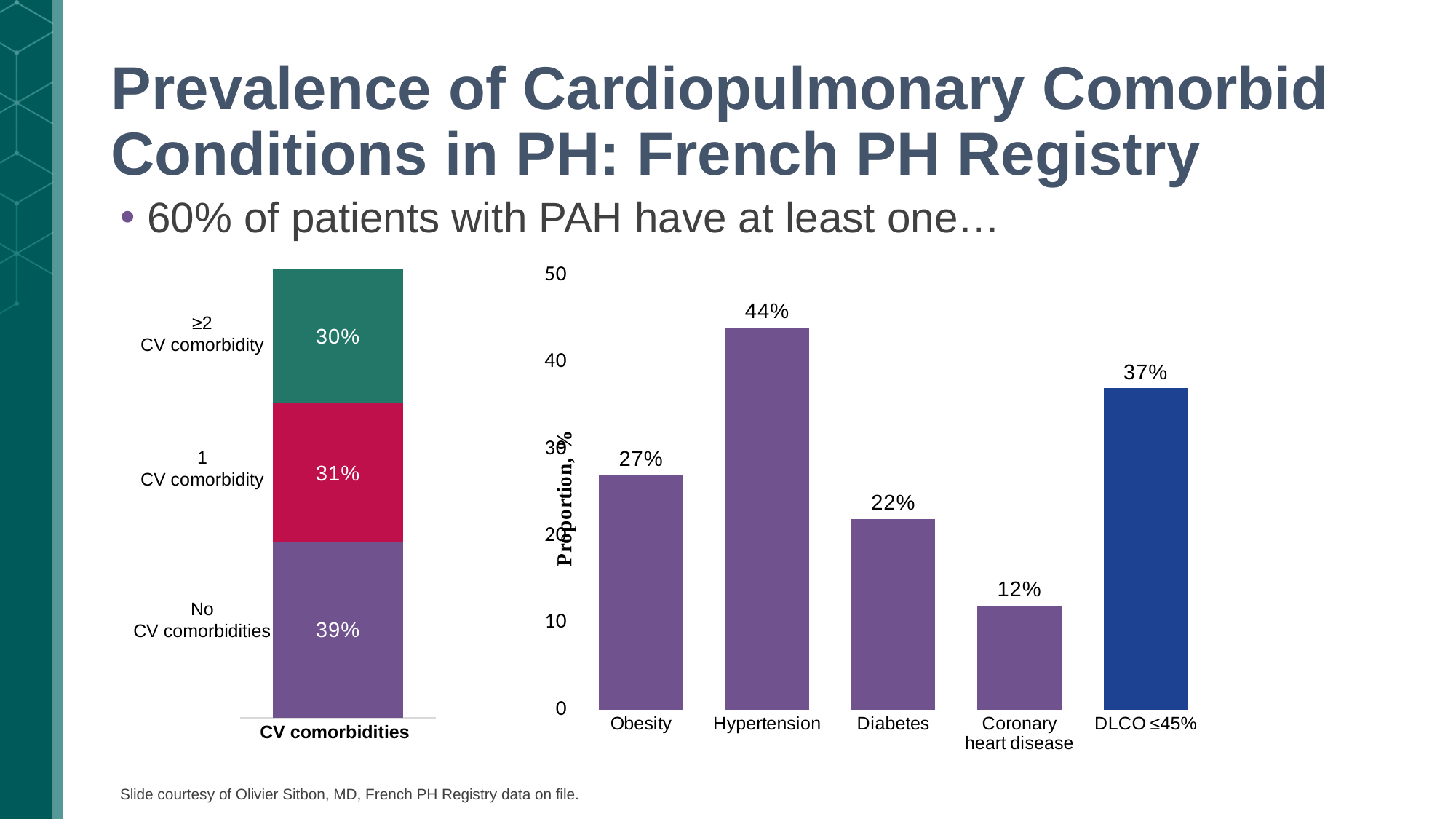
In the bar chart on the right, which category has the lowest value? Coronary heart disease In the bar chart on the right, what is the value for Hypertension? 44% In the bar chart on the right, which is larger, the value for Diabetes or the value for DLCO ≤45%? DLCO ≤45% In the bar chart on the right, which category has the highest value? Hypertension In the stacked bar chart on the left (CV comorbidities), what is the total of the three segments? 100% In the bar chart on the right, what is the difference between the values for Hypertension and Obesity? 17% How many categories are shown in the bar chart on the right? 5 In the stacked bar chart on the left (CV comorbidities), what is the value for the 'No CV comorbidities' segment? 39% In the bar chart on the right, what is the value for Coronary heart disease? 12% What type of chart is the chart on the right? Bar chart In the bar chart on the right, what is the value for DLCO ≤45%? 37% In the stacked bar chart on the left (CV comorbidities), what is the value for the '1 CV comorbidity' segment? 31%